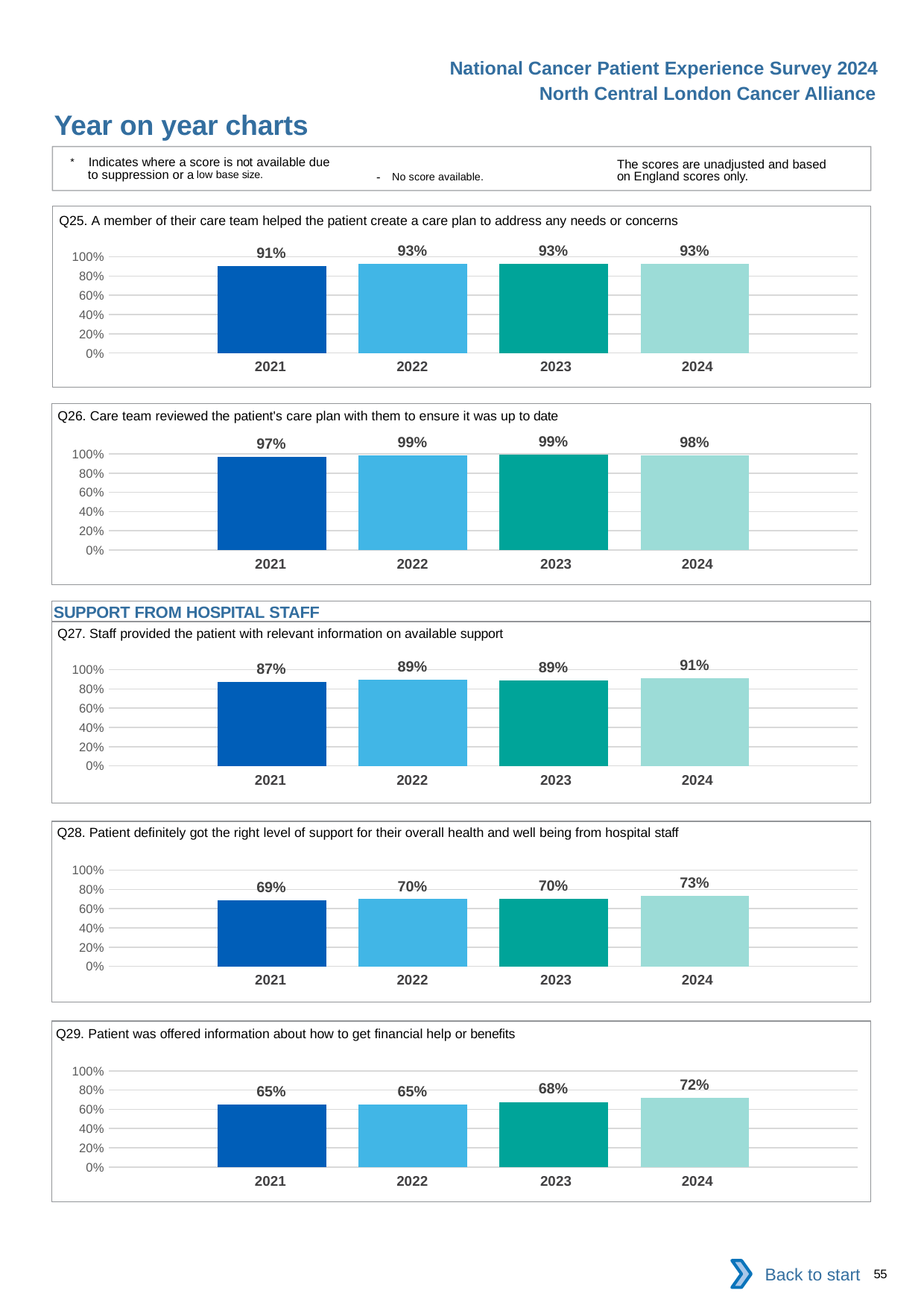
In the Q27 chart, what is the difference between the 2024 and 2021 values? 4 percentage points What kind of chart is the Q26 chart? bar chart In the Q26 chart, what is the value for 2024? 98% In the Q25 chart, what is the value for 2021? 91% In the Q26 chart, which year has the lowest value? 2021 In the Q29 chart, what is the value for 2023? 68% In the Q28 chart, is the value for 2021 greater or less than 80%? less In the Q28 chart, which year has the highest value? 2024 In the Q29 chart, is the value for 2024 larger or smaller than the value for 2021? larger In the Q29 chart, do the values rise or fall from 2022 to 2024? rise What is the section heading shown above the Q27 chart? SUPPORT FROM HOSPITAL STAFF How many years are shown in the Q27 chart? 4